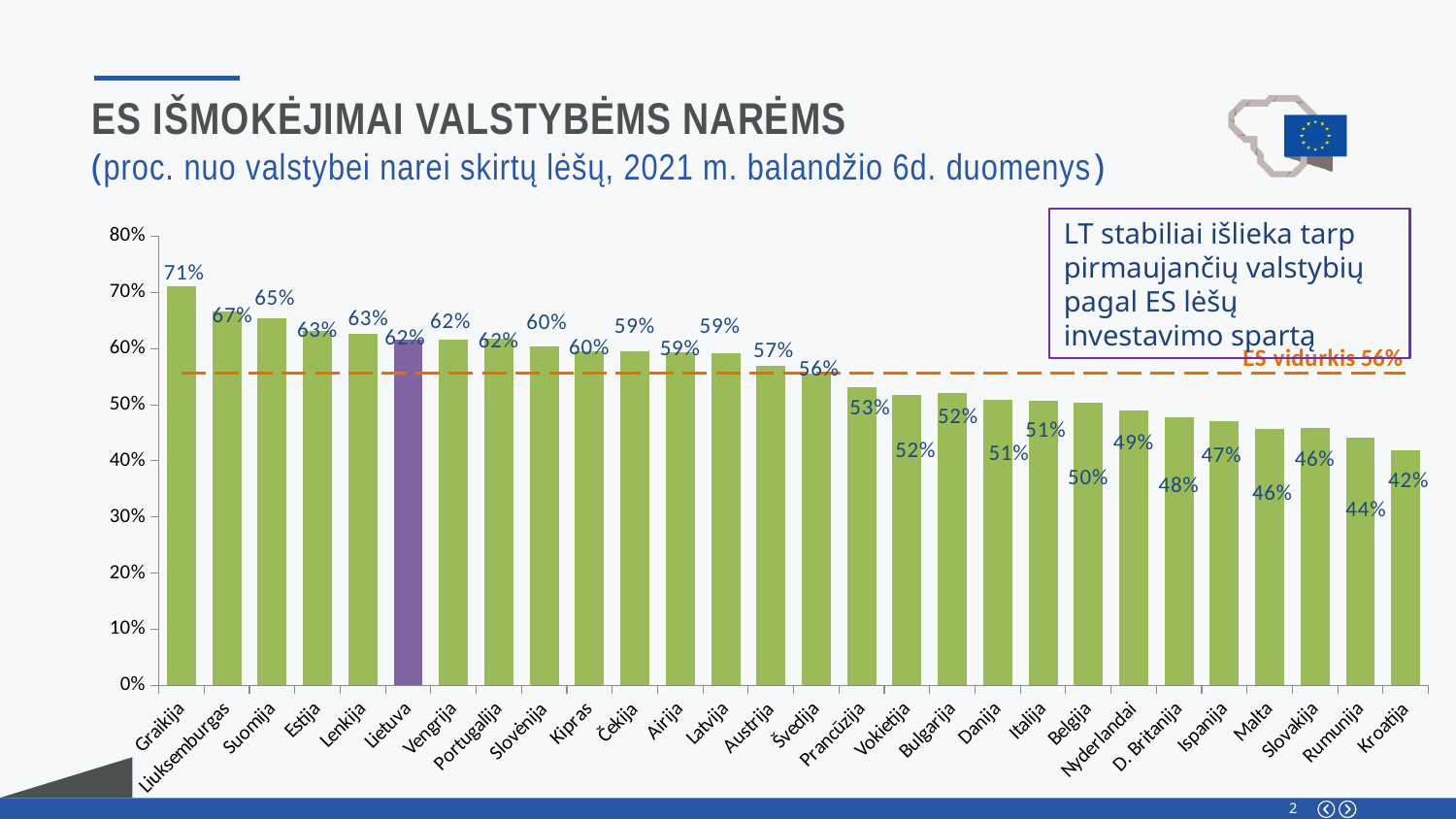
What is the value for Prancūzija? 53% Which country has the highest value? Graikija Which is larger, the value for Lenkija or the value for Malta? Lenkija Which country has the lowest value? Kroatija What is the value for Kroatija? 42% What is the difference between the values for Graikija and Kroatija? 29 percentage points What kind of chart is shown on the slide? bar chart What value does the dashed line labelled 'ES vidurkis' mark? 56% What is the value for Lietuva? 62% What is the value for Graikija? 71% Is the value for Rumunija greater or less than 50%? less How many countries are shown on the chart? 28